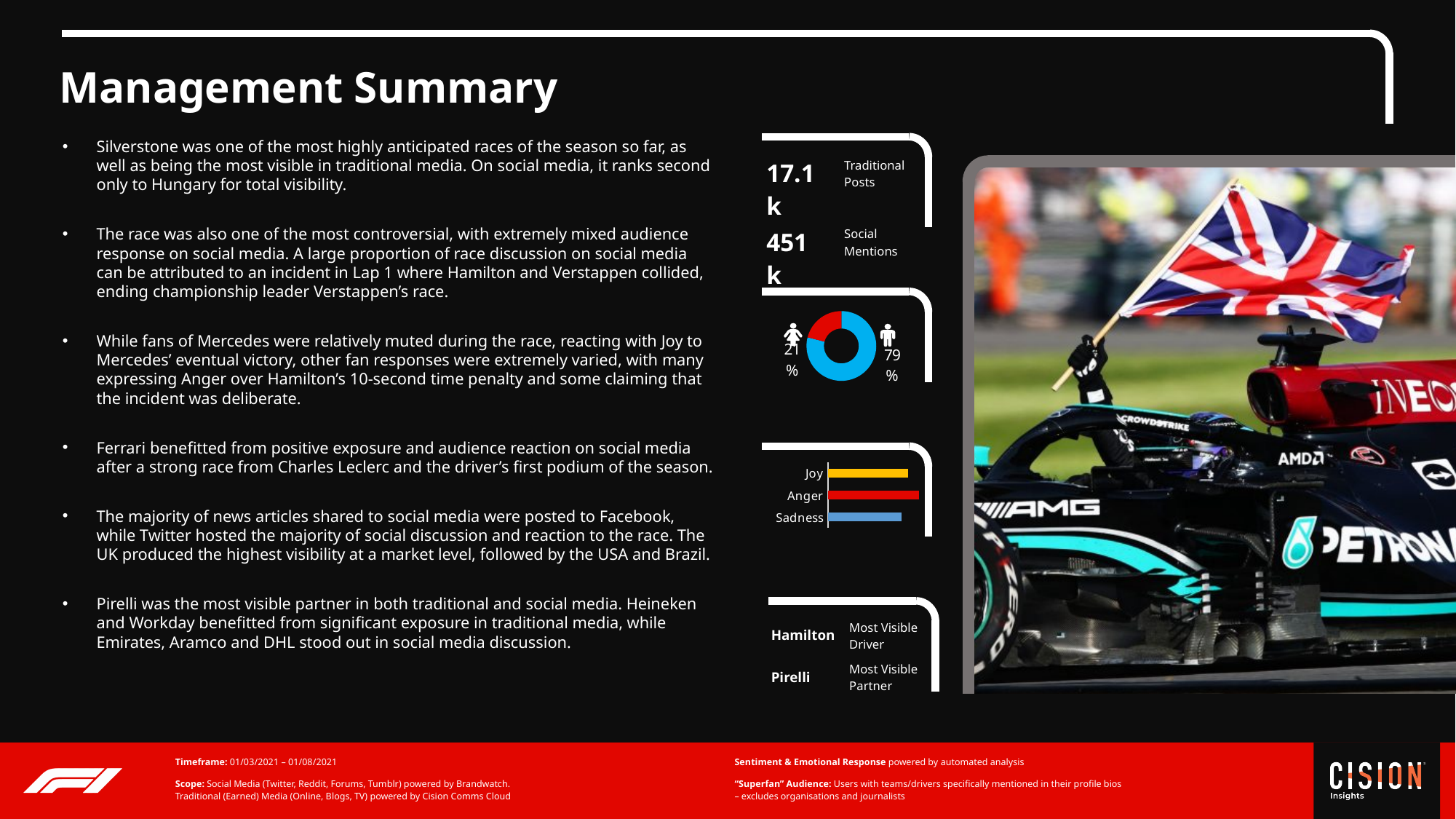
What kind of chart is the one showing 21% and 79%? Donut chart In the bar chart of Joy, Anger and Sadness, which bar is longer, Anger or Sadness? Anger In the donut chart, what is the difference between the two percentages shown? 58% In the donut chart, what percentage is shown next to the female icon? 21% In the donut chart, what colour is the larger segment? Blue In the bar chart of Joy, Anger and Sadness, how many categories are shown? 3 In the donut chart, what percentage is shown next to the male icon? 79% In the donut chart, how many segments are there? 2 What kind of chart shows Joy, Anger and Sadness? Bar chart In the bar chart of Joy, Anger and Sadness, which category has the longest bar? Anger In the bar chart of Joy, Anger and Sadness, what colour is the Joy bar? Yellow In the donut chart, which segment is larger, the one labelled 21% or the one labelled 79%? 79%